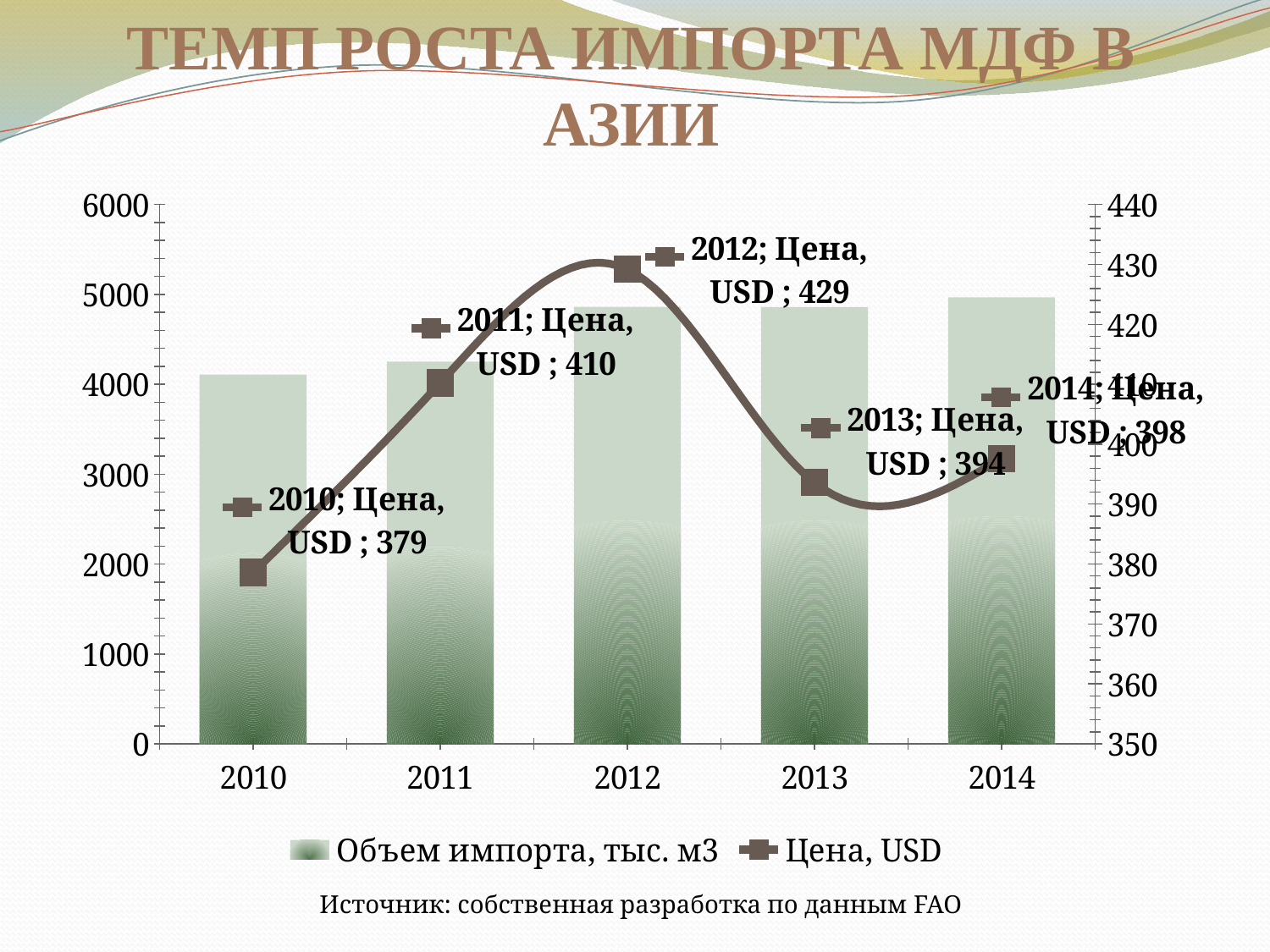
Which year has the larger Цена, USD: 2013 or 2014? 2014 In which year is Цена, USD the highest? 2012 In which year is Цена, USD the lowest? 2010 What is the value of Цена, USD for 2010? 379 What is the value of Цена, USD for 2013? 394 Does Цена, USD rise or fall from 2010 to 2012? rise Is the value of Объем импорта, тыс. м3 for 2012 greater or less than 5000? less What is the value of Цена, USD for 2012? 429 How many series does the legend list? 2 Is the value of Объем импорта, тыс. м3 for 2011 greater or less than 4000? greater What is the difference between Цена, USD in 2012 and in 2010? 50 How many years are shown on the x axis? 5